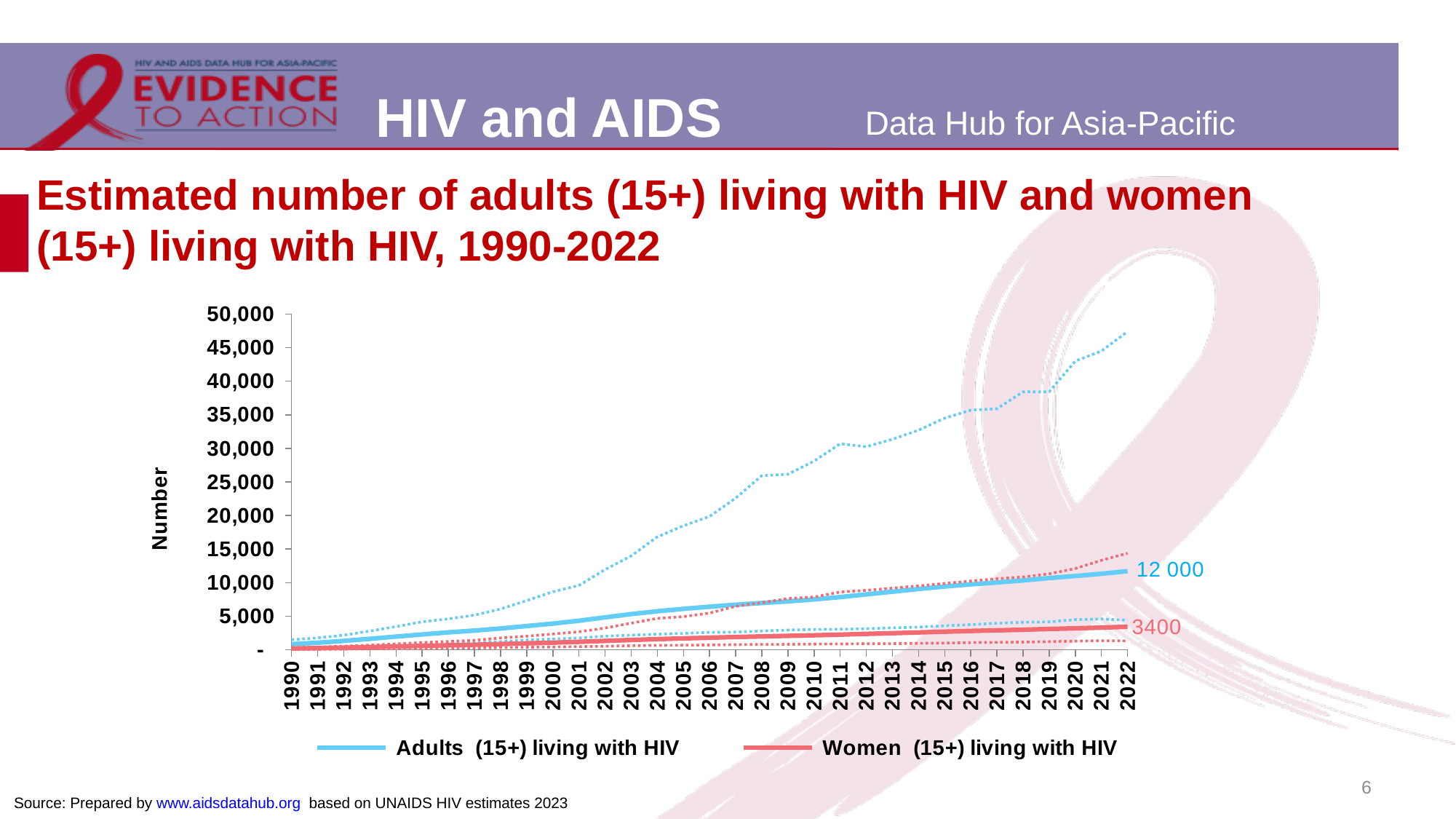
What is the difference between the labelled 2022 values for adults (15+) living with HIV and women (15+) living with HIV? 8600 Does the Adults (15+) living with HIV line rise or fall from 1990 to 2022? Rise How many years are shown on the x axis of the chart? 33 What is the estimated number of adults (15+) living with HIV in 2022, as labelled on the chart? 12 000 What kind of chart is shown on the slide? Line chart In 2022, which is larger: the number of adults (15+) living with HIV or the number of women (15+) living with HIV? Adults (15+) living with HIV Is the value of the Adults (15+) living with HIV line in 2000 greater or less than 5,000? less What is the estimated number of women (15+) living with HIV in 2022, as labelled on the chart? 3400 How many series does the chart legend list? 2 Is the value of the Women (15+) living with HIV line in 2010 greater or less than 5,000? less Is the value of the Adults (15+) living with HIV line in 2010 greater or less than 5,000? greater What is the title of the vertical axis of the chart? Number